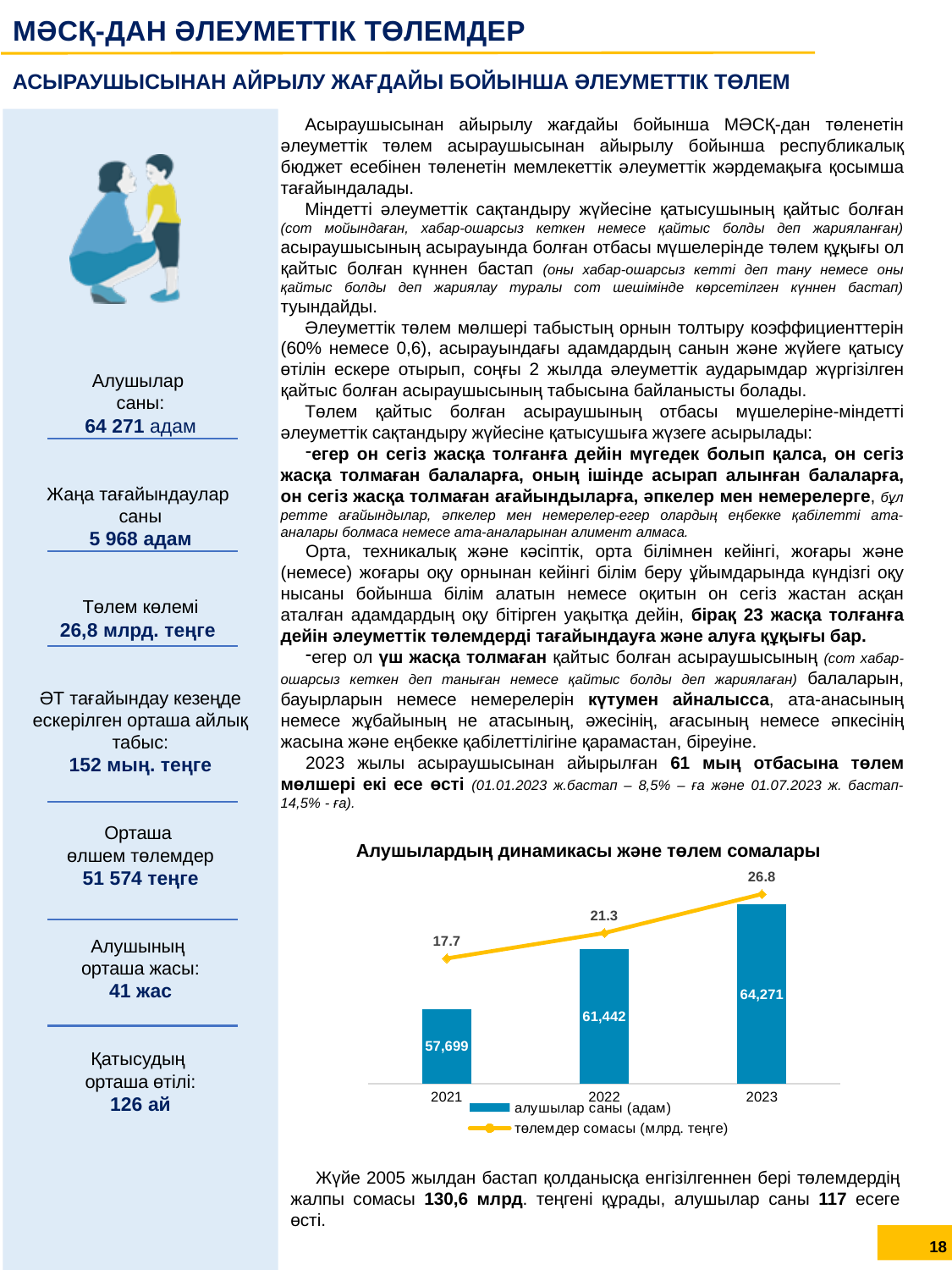
Which is larger: алушылар саны (адам) in 2022 or in 2021? 2022 What is the value of төлемдер сомасы (млрд. теңге) for 2023? 26.8 How many series does the chart legend list? 2 What is the value of алушылар саны (адам) for 2023? 64,271 What is the difference in алушылар саны (адам) between 2023 and 2021? 6,572 Which year has the highest value for алушылар саны (адам)? 2023 What is the chart title on the slide? Алушылардың динамикасы және төлем сомалары Do the values of төлемдер сомасы (млрд. теңге) rise or fall from 2021 to 2023? rise What is the difference in төлемдер сомасы (млрд. теңге) between 2023 and 2022? 5.5 Which year has the lowest value for төлемдер сомасы (млрд. теңге)? 2021 What is the value of алушылар саны (адам) for 2021? 57,699 What is the value of төлемдер сомасы (млрд. теңге) for 2022? 21.3